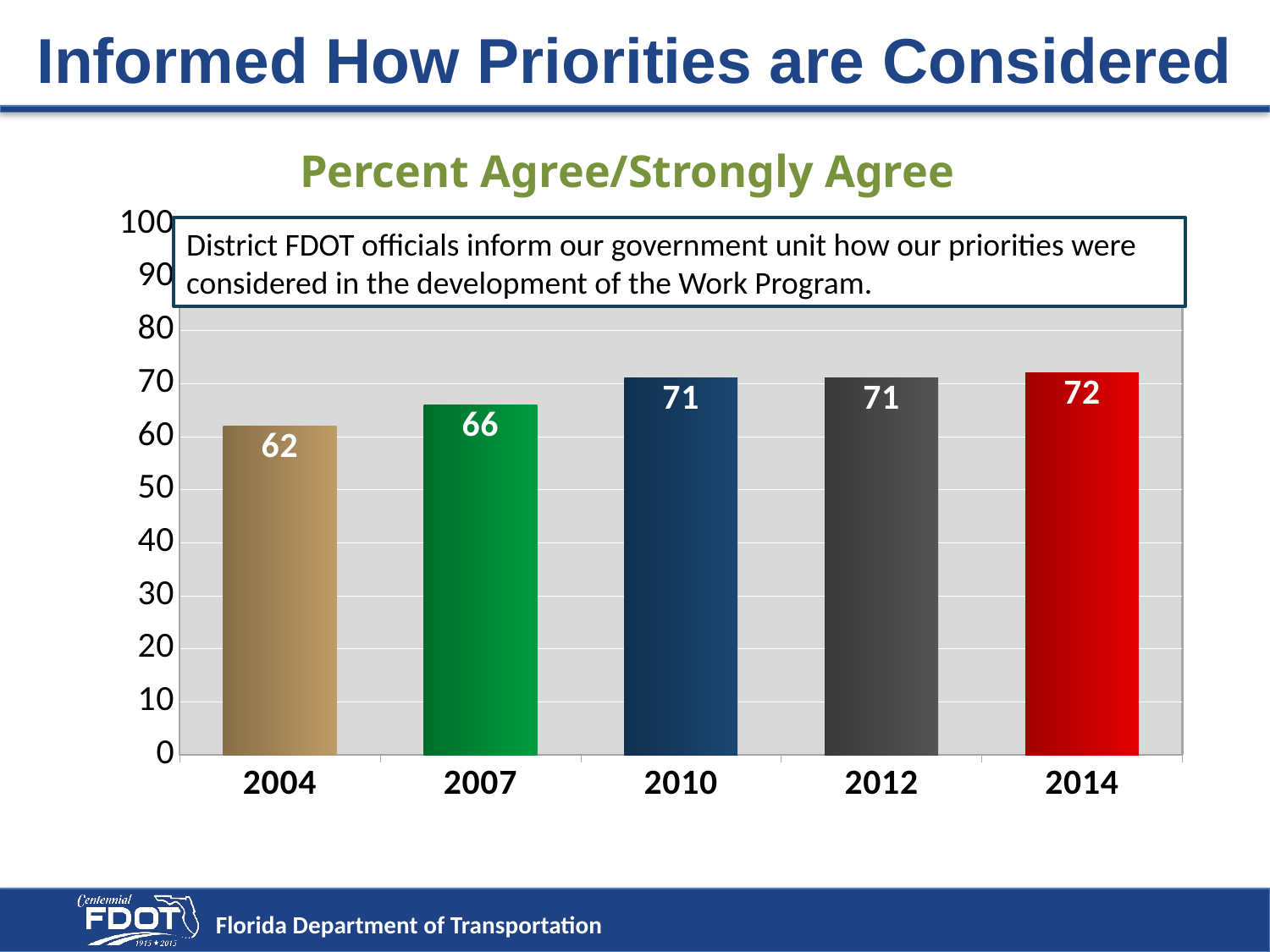
How many years are shown on the x axis? 5 What is the difference between the values for 2014 and 2004? 10 What is the difference between the values for 2007 and 2004? 4 Which year has the lowest value? 2004 What kind of chart is shown? bar chart What is the value for 2014? 72 What is the title of the chart? Percent Agree/Strongly Agree What is the value for 2004? 62 Which is larger, the value for 2007 or the value for 2010? 2010 Which year has the highest value? 2014 What is the value for 2007? 66 Is the value for 2012 greater or less than 60? greater